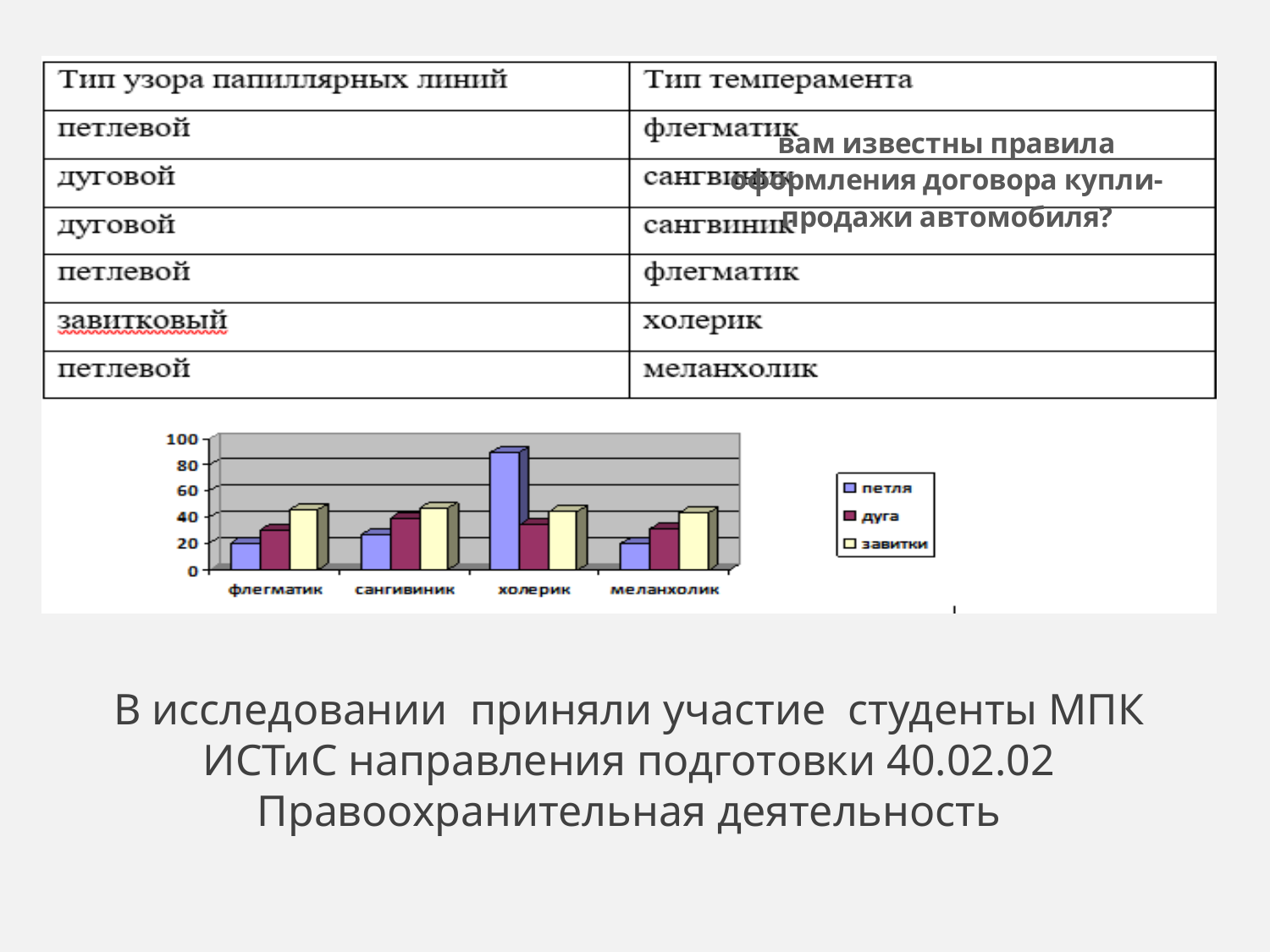
Is the value of завитки for меланхолик greater or less than 60? less Is the value of дуга for сангвиник greater or less than 20? greater Is the value of петля for флегматик greater or less than 40? less For флегматик, which is larger: the value of петля or the value of дуга? дуга Which is larger: the value of петля for холерик or the value of петля for сангвиник? холерик How many series does the chart legend list? 3 How many categories are shown on the x axis of the chart? 4 For which category is the value of the петля series highest? холерик What kind of chart is shown on the slide? bar chart Which series are listed in the chart legend? петля, дуга, завитки For холерик, which is larger: the value of петля or the value of завитки? петля